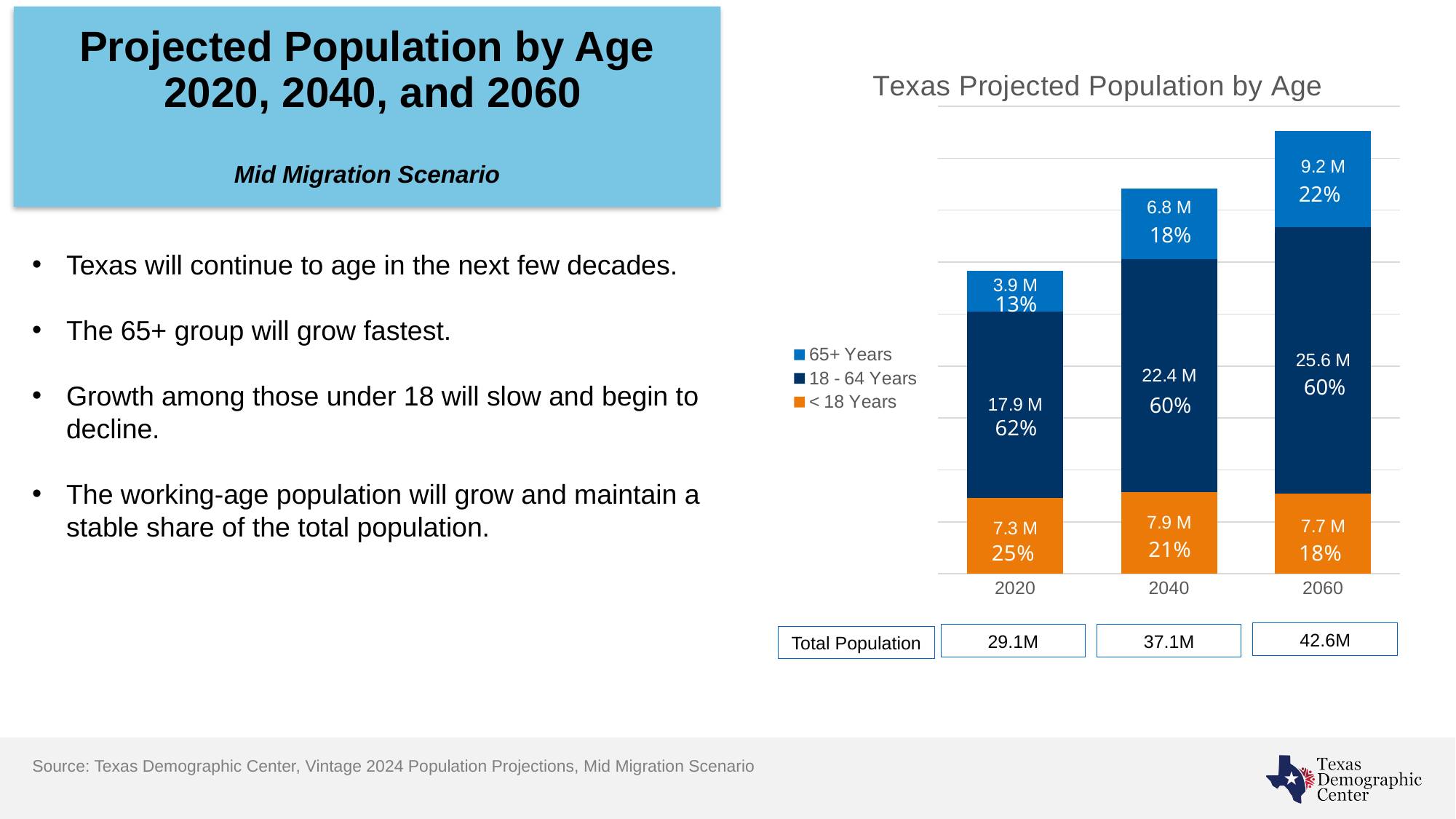
What is the title of the chart? Texas Projected Population by Age Which year has the highest 65+ Years population? 2060 What kind of chart is shown on the slide? Stacked bar chart What is the projected < 18 Years population in 2040? 7.9 M What share of the population is 18 - 64 Years in 2020? 62% How many years are shown on the x axis of the chart? 3 How many series does the chart legend list? 3 What is the projected 65+ Years population in 2060? 9.2 M What is the total population shown for 2040? 37.1M Which is larger, the < 18 Years population in 2040 or in 2060? 2040 Which year has the lowest 18 - 64 Years population? 2020 What is the difference between the 18 - 64 Years population in 2060 and in 2020? 7.7 M